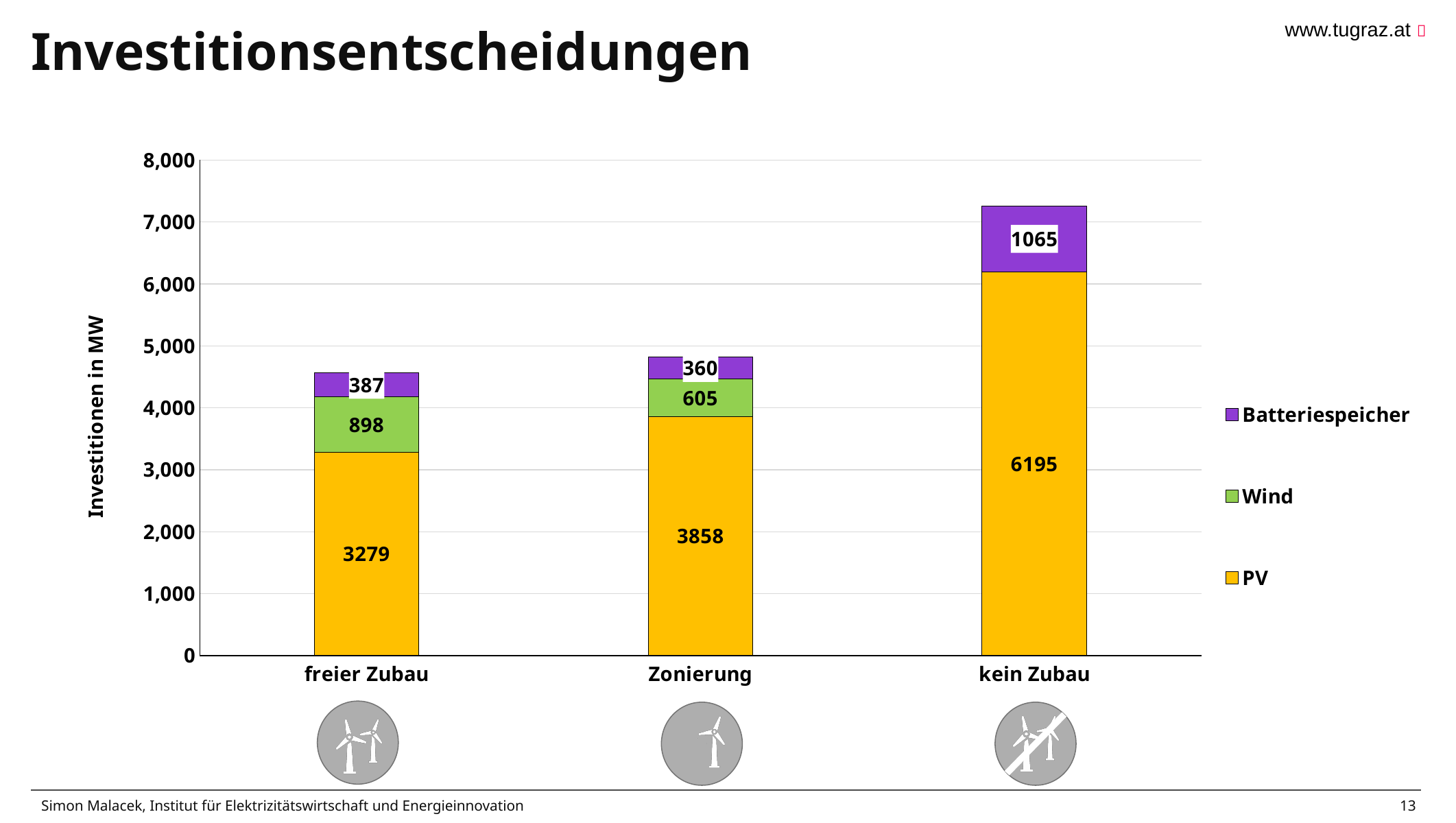
Is the total height of the kein Zubau bar greater or less than 7,000? greater Is the Wind value larger for freier Zubau or for Zonierung? freier Zubau What is the Batteriespeicher value for kein Zubau? 1065 Which category has the lowest Batteriespeicher value? Zonierung What type of chart is shown on the slide? stacked bar chart How many series does the legend list? 3 What is the total of the stacked bar for freier Zubau? 4564 What is the PV value for Zonierung? 3858 How many categories are shown on the x axis? 3 What is the difference between the PV values for kein Zubau and freier Zubau? 2916 Which category has the highest PV value? kein Zubau What is the Wind value for freier Zubau? 898